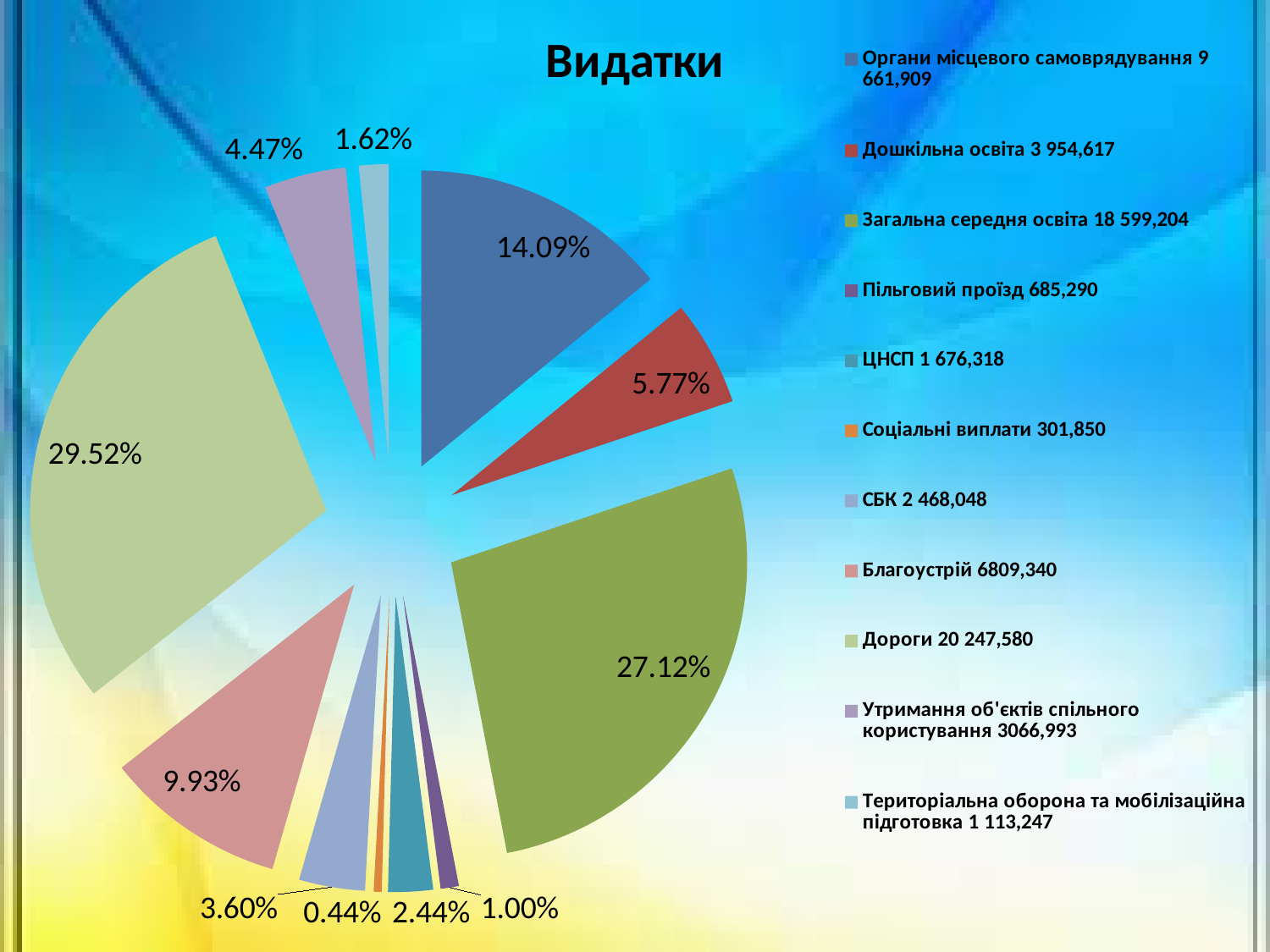
What percentage is shown for Благоустрій? 9.93% What amount is listed in the legend for Дошкільна освіта? 3 954,617 What percentage is shown for Органи місцевого самоврядування? 14.09% What is the title of the chart? Видатки What kind of chart is shown on the slide? pie chart Which is larger, the share for Дошкільна освіта or the share for Благоустрій? Благоустрій Which category has the largest slice of the pie? Дороги What share of the pie does Дороги take? 29.52% Which category has the smallest slice of the pie? Соціальні виплати How many categories does the legend of the chart list? 11 What is the difference in percentage points between Дороги and Загальна середня освіта? 2.40 What share of the pie does Загальна середня освіта take? 27.12%